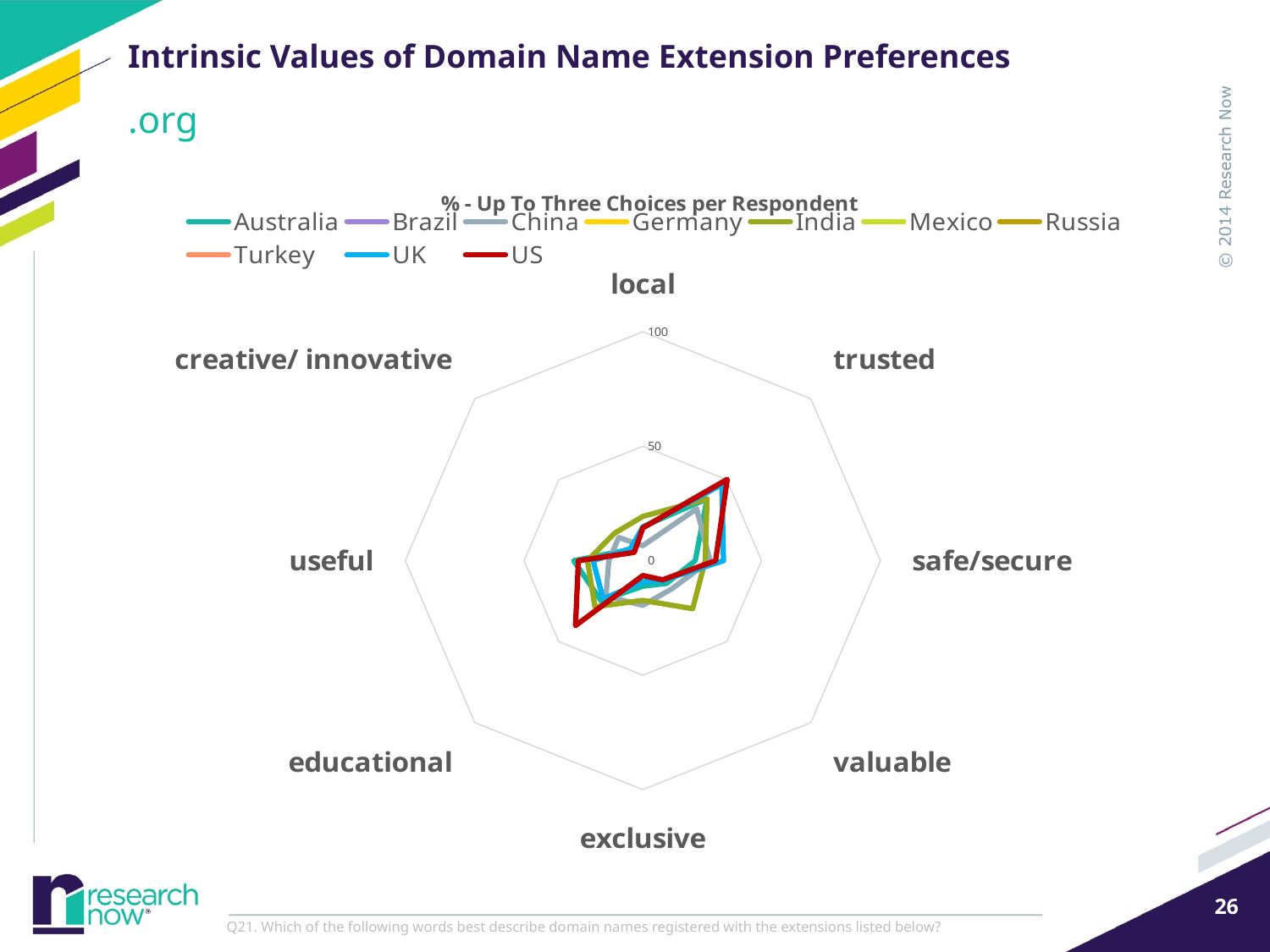
Is the value for 'creative/ innovative' for the UK greater or less than 50? less Is the value for 'local' for the US greater or less than 50? less How many series (countries) does the legend list? 10 Is the value for 'useful' for the US greater or less than 50? less How many attribute categories (axes) does the radar chart have? 8 What kind of chart is shown on the slide? radar chart Which country is plotted with the red line in the chart? US What is the title of the chart? % - Up To Three Choices per Respondent